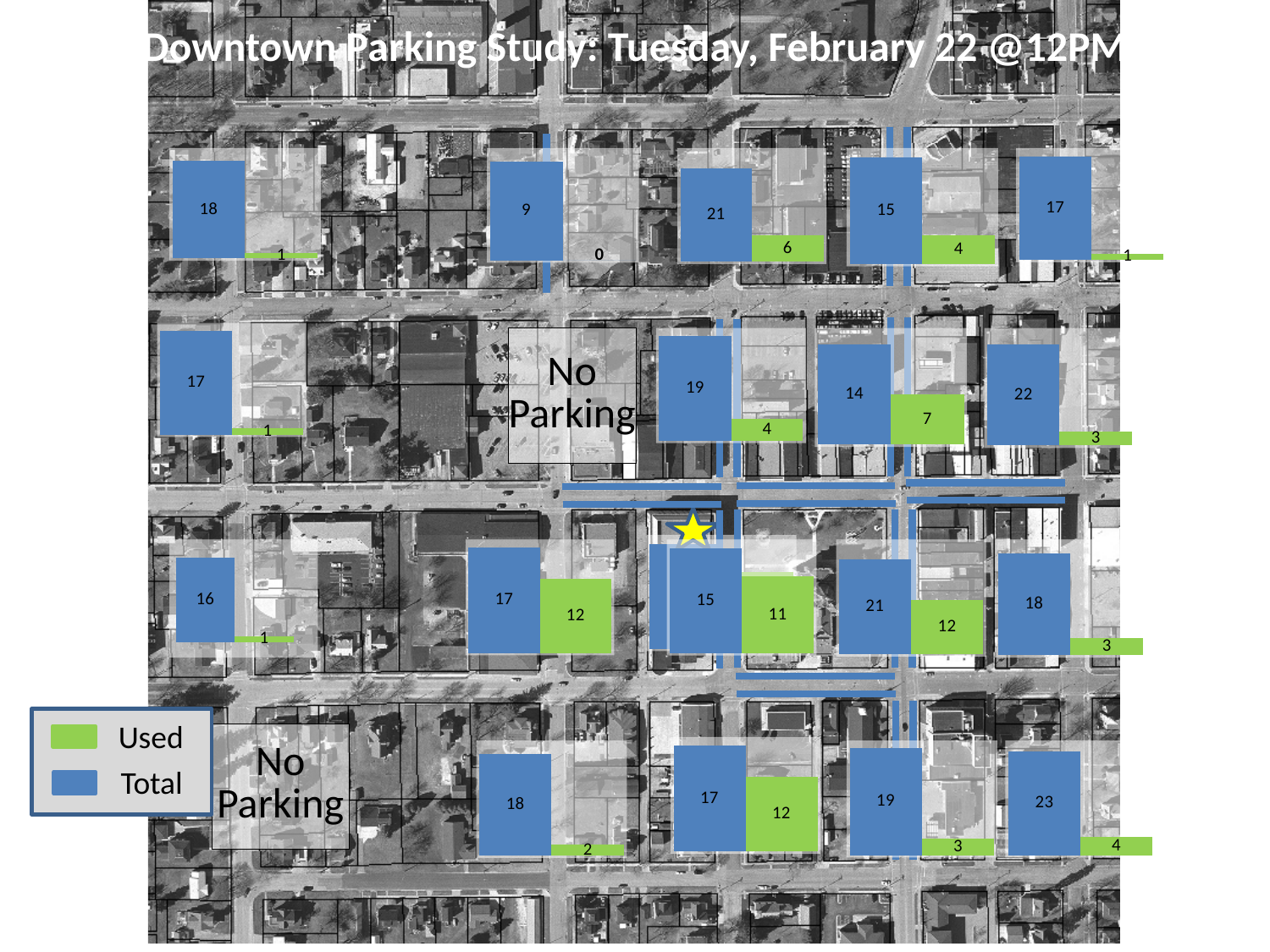
What is the title of the slide? Downtown Parking Study: Tuesday, February 22 @12PM What is the Used value for the block in the bottom-right corner of the map? 4 What is the smallest Total value shown on any block in the map? 9 What is the highest Used value shown on any block in the map? 12 What is the Total value for the block in the top-left corner of the map? 18 How many series does the legend list? 2 What is the difference between Total and Used for the block in the bottom-right corner of the map? 19 What is the smallest Used value shown on any block in the map? 0 Which is larger for the block in the top-left corner of the map, Total or Used? Total What is the Total value for the block in the bottom-right corner of the map? 23 Which colour represents Used in the legend? Green What is the largest Total value shown on any block in the map? 23